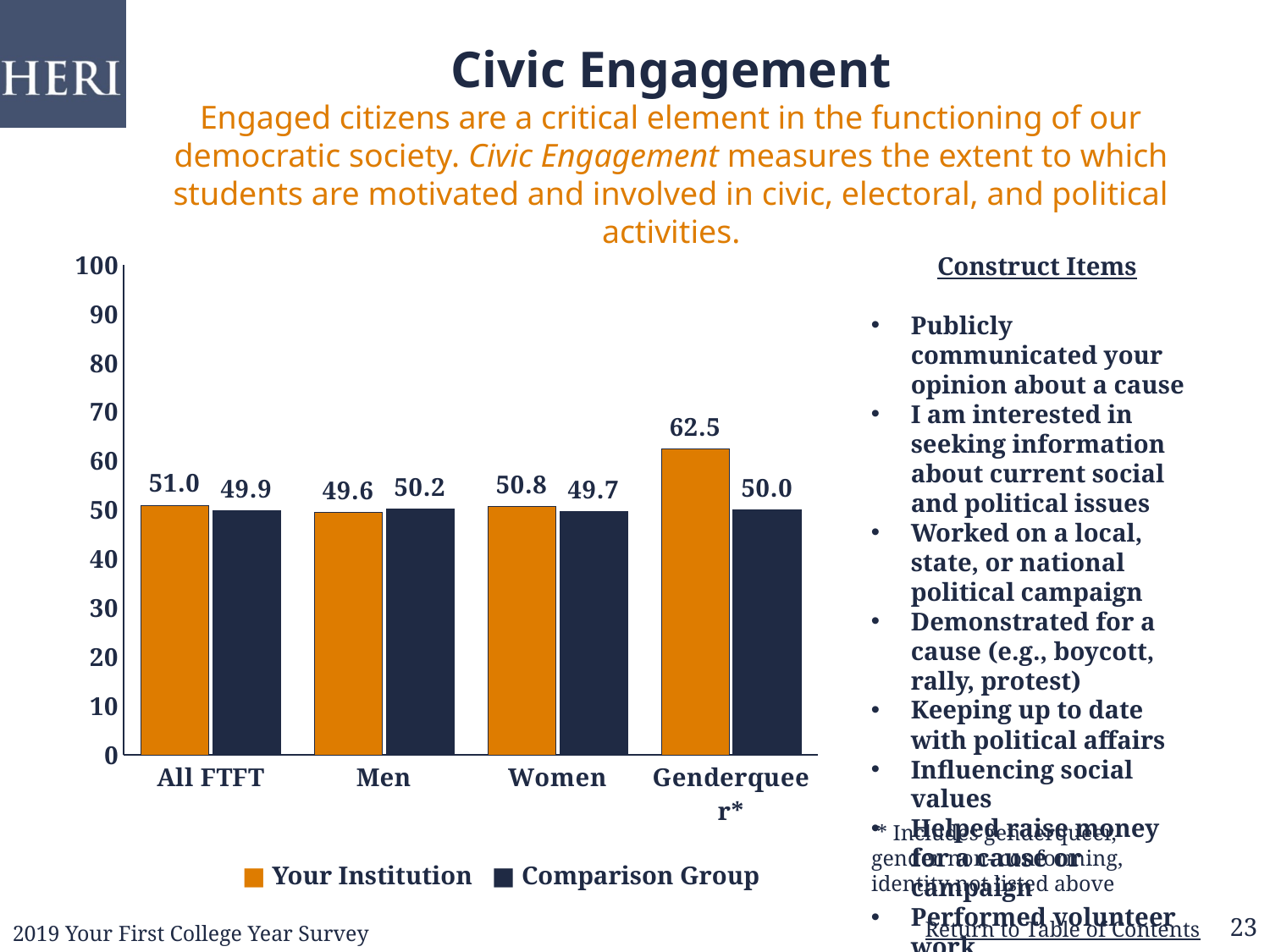
What is the Your Institution value for All FTFT? 51.0 Which category has the lowest Your Institution value? Men How many series does the legend list? 2 Which category has the highest Your Institution value? Genderqueer Is the Your Institution value for Genderqueer greater or less than 60? greater How many categories are shown on the x axis? 4 What is the Your Institution value for Genderqueer? 62.5 What kind of chart is shown on the slide? bar chart What is the difference between the Your Institution and Comparison Group values for Genderqueer? 12.5 What is the Comparison Group value for Women? 49.7 What is the Comparison Group value for Men? 50.2 For Men, which is larger: the Your Institution value or the Comparison Group value? Comparison Group